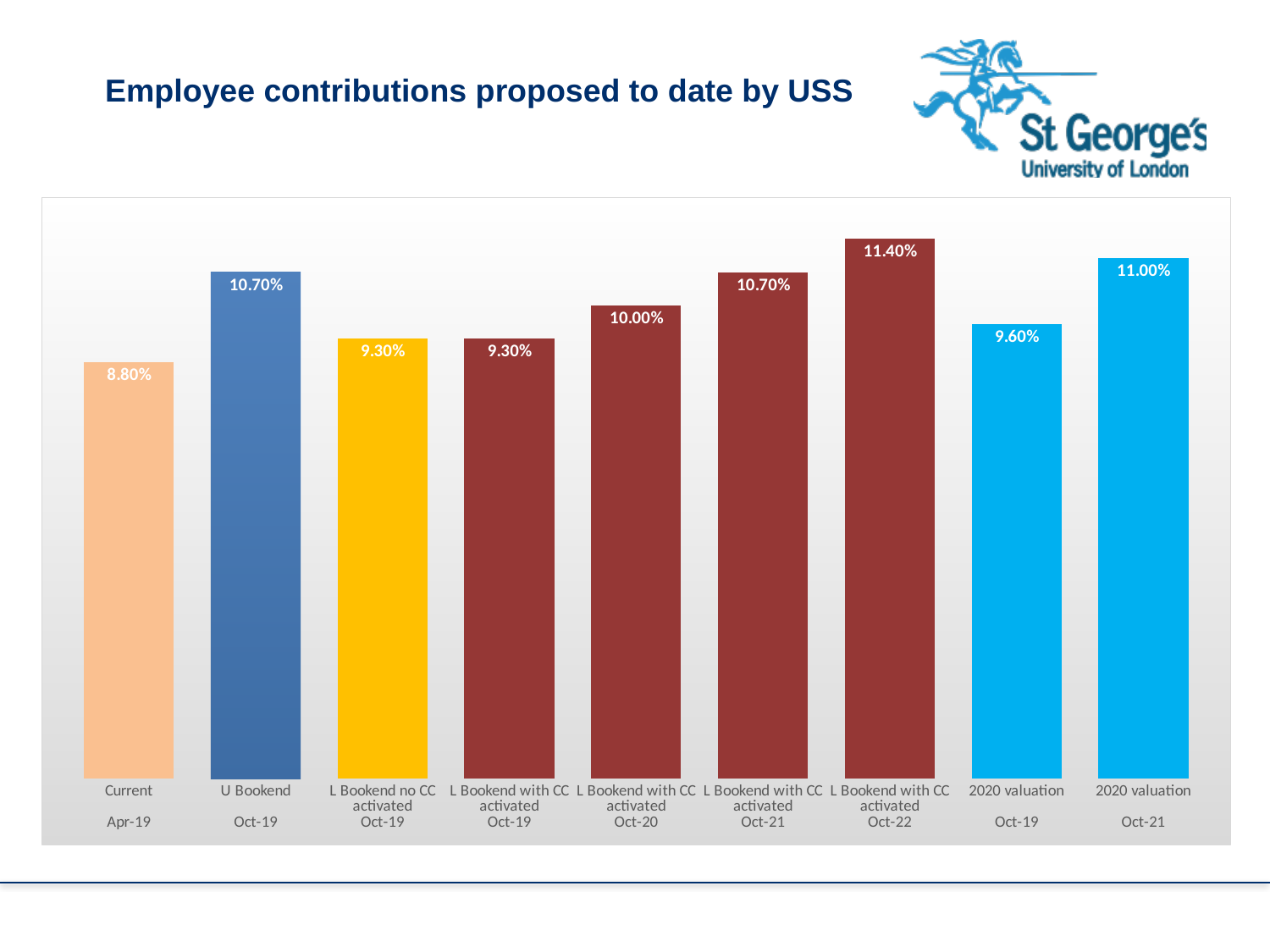
What is the difference between the value for L Bookend with CC activated (Oct-22) and the value for Current (Apr-19)? 2.60% How many bars are shown in the chart? 9 What is the value for 2020 valuation (Oct-21)? 11.00% What is the value for L Bookend no CC activated (Oct-19)? 9.30% Which category has the highest value? L Bookend with CC activated Oct-22 What is the value for U Bookend (Oct-19)? 10.70% What kind of chart is shown on the slide? Bar chart What is the value for Current (Apr-19)? 8.80% What is the value for L Bookend with CC activated (Oct-22)? 11.40% Which category has the lowest value? Current Apr-19 What is the difference between the 2020 valuation Oct-21 value and the 2020 valuation Oct-19 value? 1.40% Which is larger, the value for 2020 valuation (Oct-19) or the value for L Bookend with CC activated (Oct-20)? L Bookend with CC activated (Oct-20)